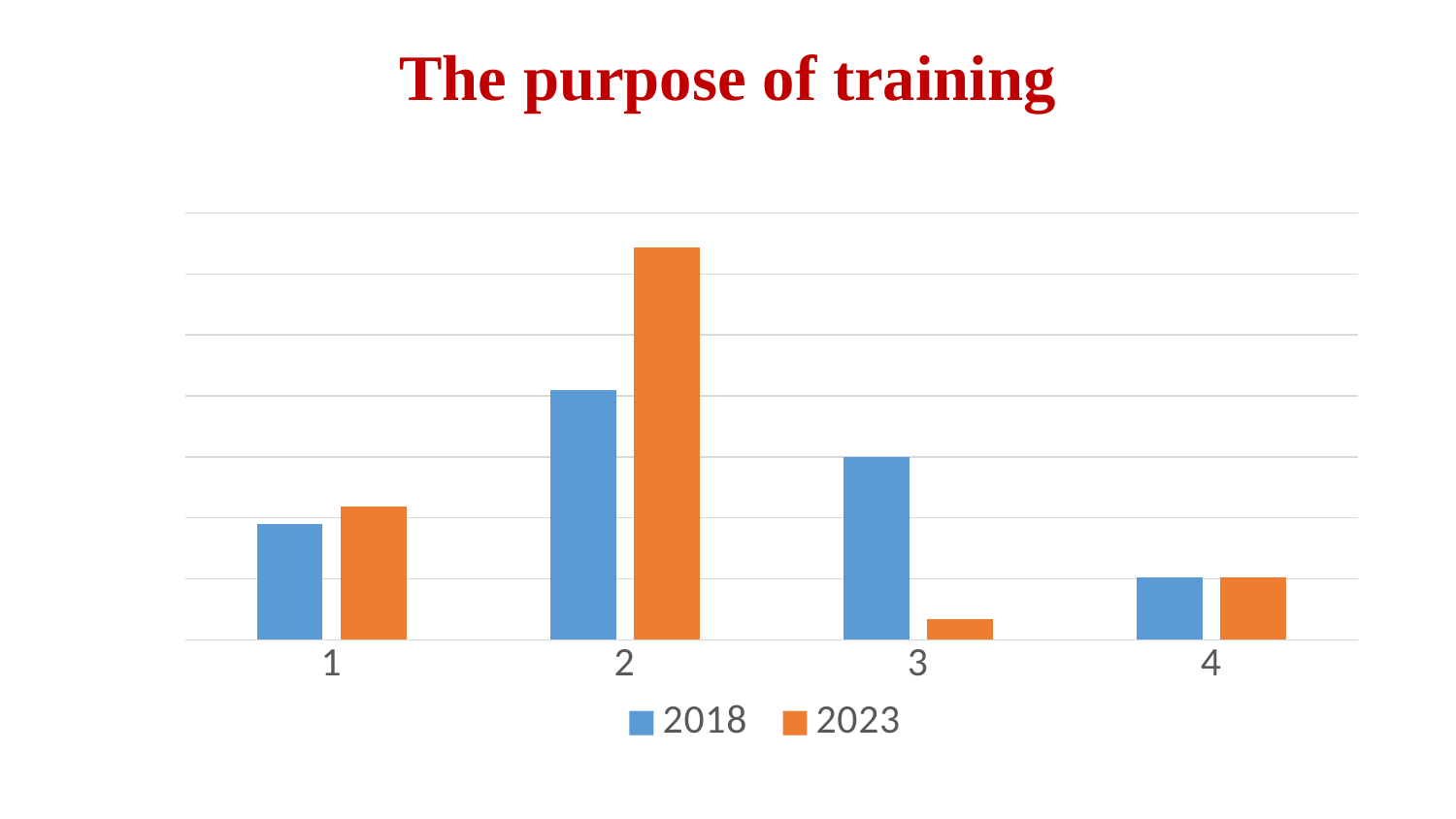
For category 1, which series has the larger value, 2018 or 2023? 2023 What is the title of the slide containing the chart? The purpose of training How many series does the chart's legend list? 2 Which category has the lowest value for the 2023 series? 3 Which category has the highest value for the 2023 series? 2 Which series is shown in orange in the chart? 2023 Which category has the lowest value for the 2018 series? 4 Which category has the highest value for the 2018 series? 2 For category 2, which series has the larger value, 2018 or 2023? 2023 What kind of chart is shown on the slide? bar chart For category 3, which series has the larger value, 2018 or 2023? 2018 How many categories are shown on the x axis of the chart? 4